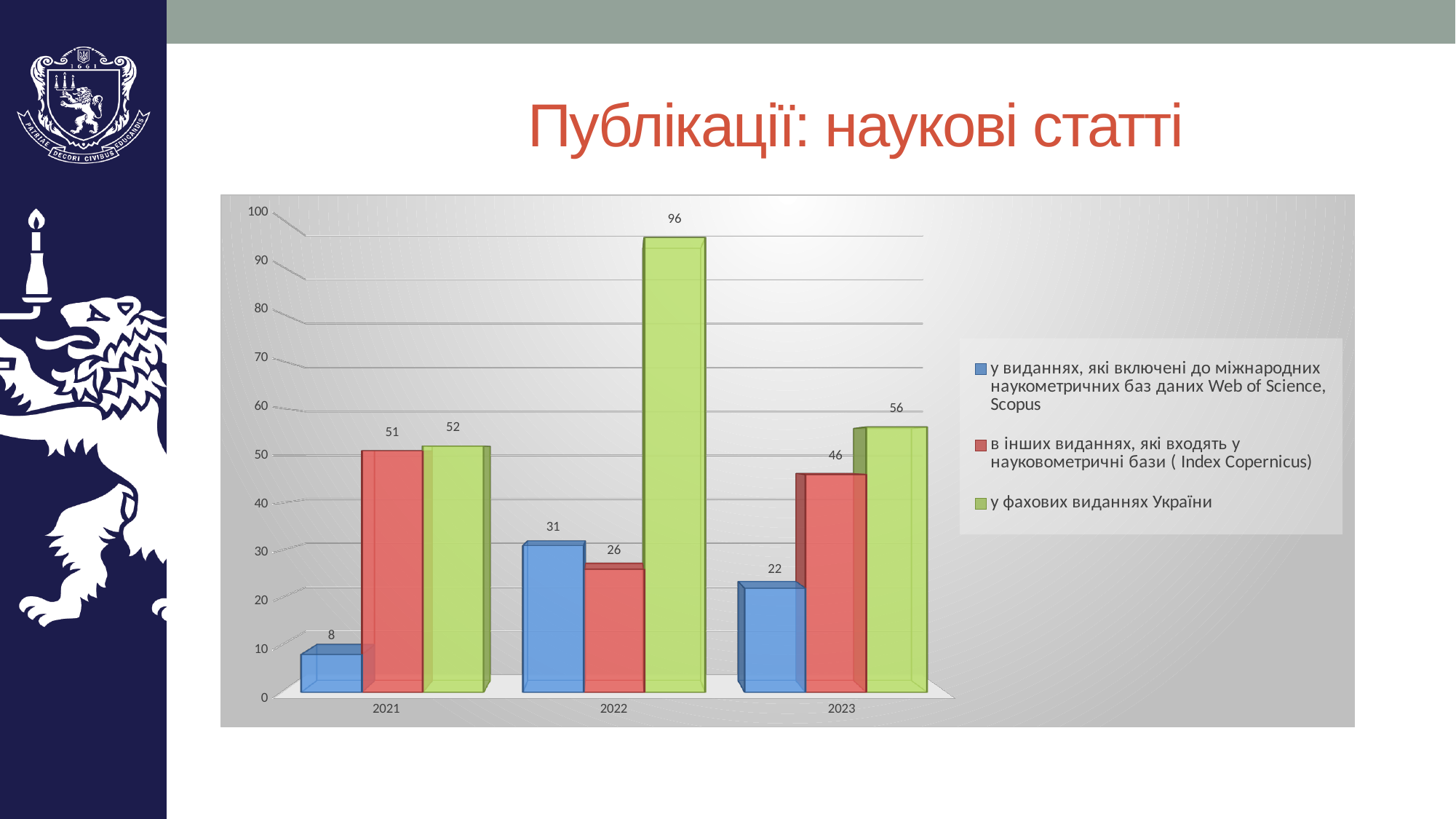
What is the difference between the 2022 and 2023 values in the series 'у фахових виданнях України'? 40 Which year has the highest value in the series 'у фахових виданнях України'? 2022 What is the value for 2022 in the series 'у фахових виданнях України'? 96 Is the value for 2021 in the series 'в інших виданнях, які входять у науковометричні бази ( Index Copernicus)' greater or less than 40? greater In 2022, which is larger: the value for 'у виданнях, які включені до міжнародних наукометричних баз даних Web of Science, Scopus' or the value for 'в інших виданнях, які входять у науковометричні бази ( Index Copernicus)'? у виданнях, які включені до міжнародних наукометричних баз даних Web of Science, Scopus How many years are shown on the x axis of the chart? 3 What is the title of the slide containing the chart? Публікації: наукові статті What is the value for 2023 in the series 'в інших виданнях, які входять у науковометричні бази ( Index Copernicus)'? 46 What is the value for 2021 in the series 'у виданнях, які включені до міжнародних наукометричних баз даних Web of Science, Scopus'? 8 Which year has the lowest value in the series 'у виданнях, які включені до міжнародних наукометричних баз даних Web of Science, Scopus'? 2021 What kind of chart is shown on the slide? bar chart How many series does the chart legend list? 3